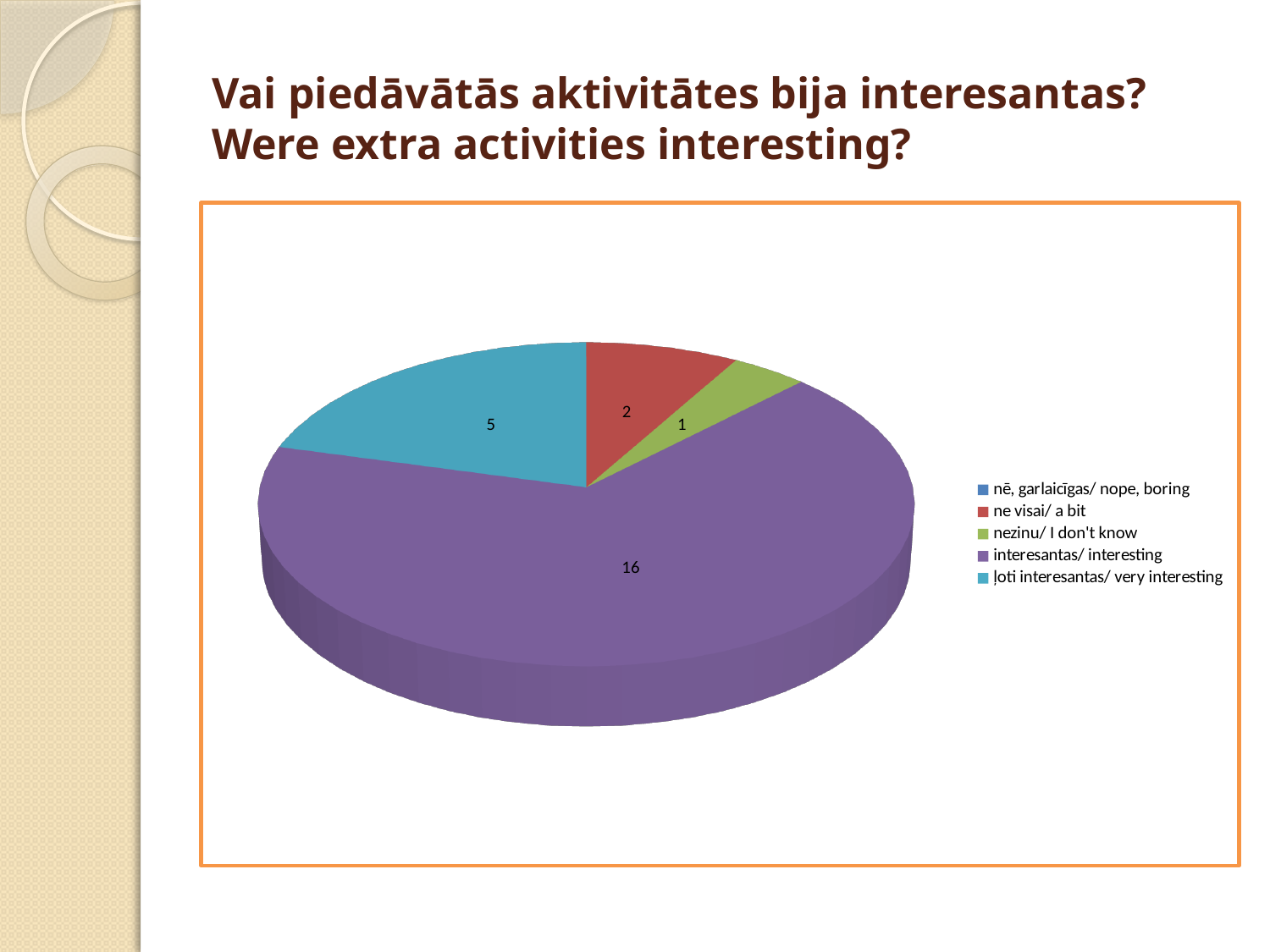
What is the value for "interesantas/ interesting"? 16 What kind of chart is shown on the slide? pie chart Which is larger, the value for "ne visai/ a bit" or the value for "ļoti interesantas/ very interesting"? ļoti interesantas/ very interesting What colour is the slice for "interesantas/ interesting"? purple What is the value for "nezinu/ I don't know"? 1 What is the English part of the slide title? Were extra activities interesting? What is the difference between the values for "interesantas/ interesting" and "ļoti interesantas/ very interesting"? 11 What is the value for "ne visai/ a bit"? 2 What is the value for "ļoti interesantas/ very interesting"? 5 How many entries does the legend list? 5 Which category has the largest slice of the pie? interesantas/ interesting Among the slices with printed values, which category has the smallest value? nezinu/ I don't know